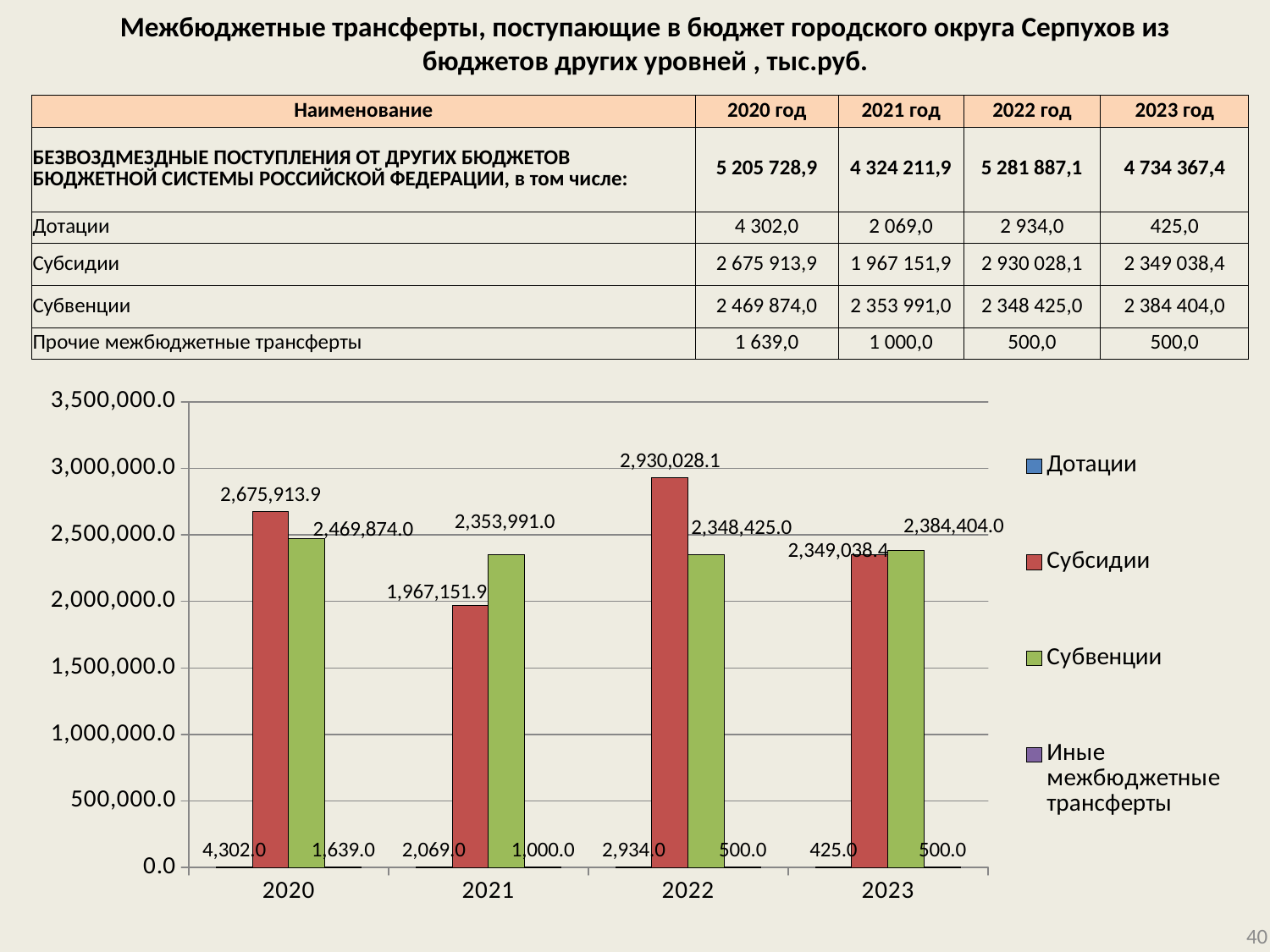
In which year is the Субсидии bar lowest in the chart? 2021 What is the value of Субсидии for 2022 in the chart? 2,930,028.1 What is the value of Иные межбюджетные трансферты for 2021 in the chart? 1,000.0 How many series does the chart legend list? 4 What kind of chart is shown on the slide? bar chart What is the value of Дотации for 2020 in the chart? 4,302.0 Which is larger in 2021 in the chart: Субсидии or Субвенции? Субвенции What is the value of Субвенции for 2021 in the chart? 2,353,991.0 What is the difference between Субсидии and Субвенции in 2022 in the chart? 581,603.1 Is the value for Субсидии in 2020 greater or less than 2,500,000.0? greater In which year is the Субсидии bar highest in the chart? 2022 How many years are shown on the x axis of the chart? 4